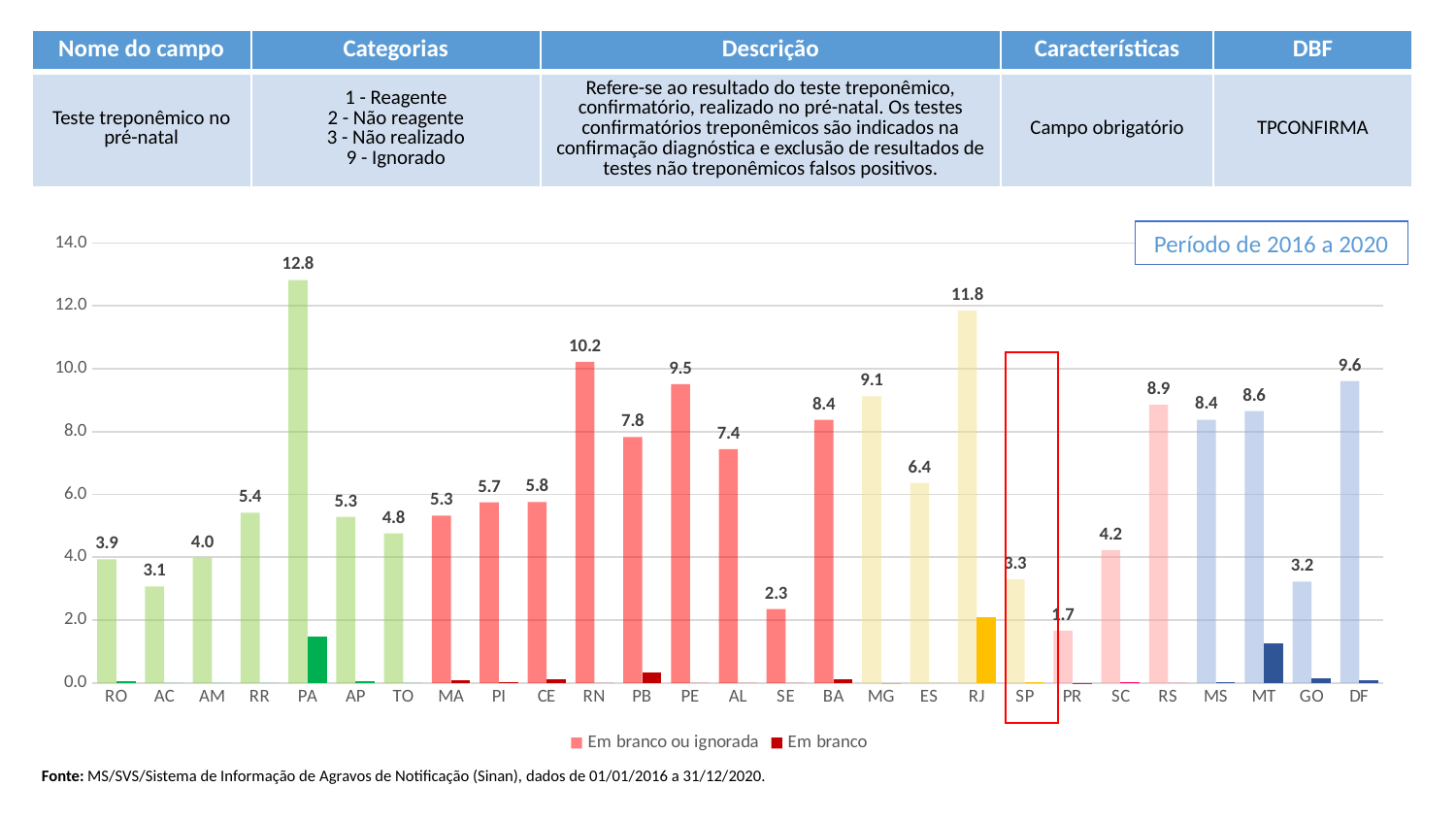
What is the value for RJ in the 'Em branco ou ignorada' series? 11.8 What is the difference between the 'Em branco ou ignorada' values for PA and RJ? 1.0 How many states are shown on the x axis of the chart? 27 What is the value for PA in the 'Em branco ou ignorada' series? 12.8 What period does the chart cover, according to the label in the top right of the chart? Período de 2016 a 2020 Which state has the highest value in the 'Em branco ou ignorada' series? PA What is the value for SP in the 'Em branco ou ignorada' series? 3.3 Which has a larger 'Em branco ou ignorada' value, RN or PE? RN Which state has the lowest value in the 'Em branco ou ignorada' series? PR How many series does the legend list? 2 What kind of chart is shown on the slide? Bar chart Is the 'Em branco' value for PA greater or less than 2.0? less